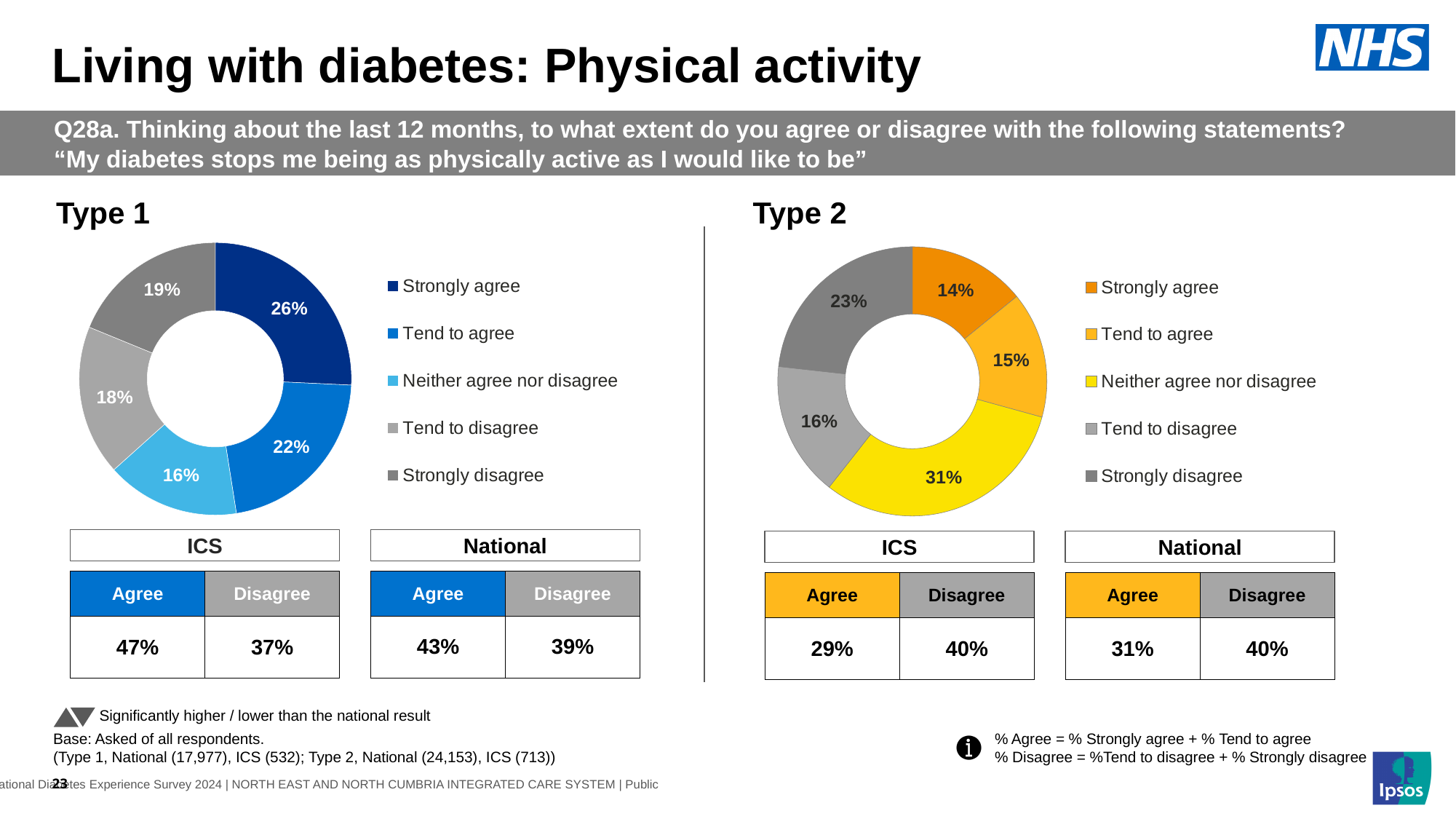
In the Type 2 chart, which response category has the smallest share? Strongly agree What kind of chart is used for the Type 1 results? Donut (pie) chart How many response categories does the legend of the Type 2 chart list? 5 In the Type 1 chart, which response category has the smallest share? Neither agree nor disagree In the Type 2 chart, what is the difference between the share for Neither agree nor disagree and the share for Strongly agree? 17% In the Type 2 chart, what percentage of respondents said they neither agree nor disagree? 31% In the Type 1 chart, which is larger: the share for Tend to agree or the share for Strongly disagree? Tend to agree In the Type 1 chart, what percentage of respondents said they tend to disagree? 18% In the Type 1 chart, what percentage of respondents said they strongly agree? 26% In the Type 2 chart, what colour represents Neither agree nor disagree? Yellow In the Type 2 chart, what percentage of respondents said they strongly disagree? 23% In the Type 1 chart, which response category has the largest share? Strongly agree